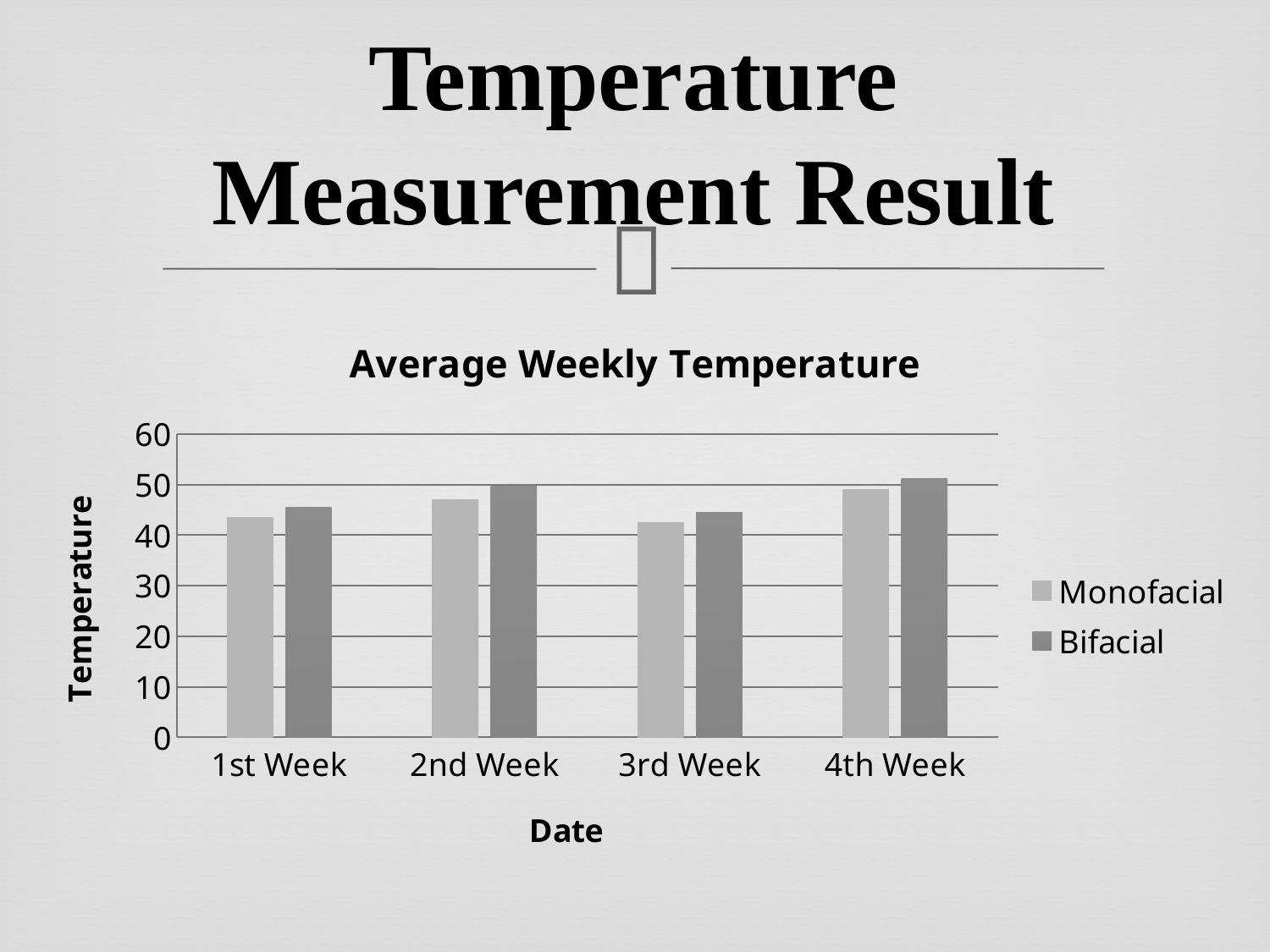
In 2nd Week, which series has the larger value, Monofacial or Bifacial? Bifacial How many week categories are shown on the x axis? 4 What is the label of the vertical axis? Temperature For the Monofacial series, which is larger, the 2nd Week value or the 3rd Week value? 2nd Week What is the title of the chart? Average Weekly Temperature Is the Bifacial value for 1st Week greater or less than 50? less For the Monofacial series, which week has the highest value? 4th Week Is the Bifacial value for 3rd Week greater or less than 50? less What kind of chart is shown on the slide? bar chart Is the Monofacial value for 2nd Week greater or less than 50? less How many series does the legend list? 2